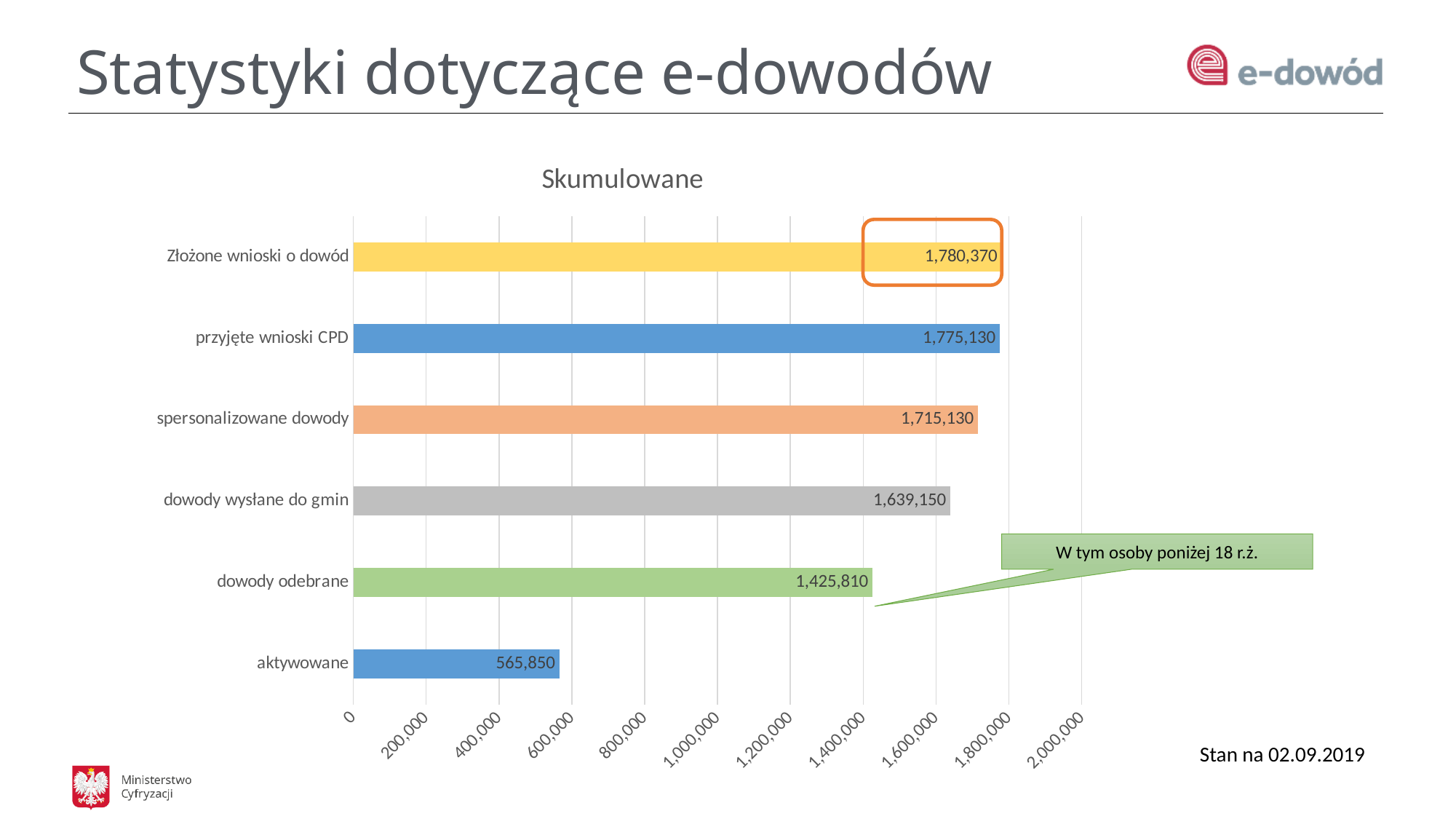
What kind of chart is shown on the slide? bar chart How many categories are shown in the chart? 6 What is the value for "aktywowane"? 565,850 What is the value for "dowody odebrane"? 1,425,810 Which category has the lowest value? aktywowane Which category has the highest value? Złożone wnioski o dowód What is the difference between "dowody wysłane do gmin" and "dowody odebrane"? 213,340 What is the value for "spersonalizowane dowody"? 1,715,130 What is the difference between "przyjęte wnioski CPD" and "spersonalizowane dowody"? 60,000 Which is larger, the value for "dowody wysłane do gmin" or the value for "aktywowane"? dowody wysłane do gmin What is the value for "Złożone wnioski o dowód"? 1,780,370 What is the title of the chart? Skumulowane